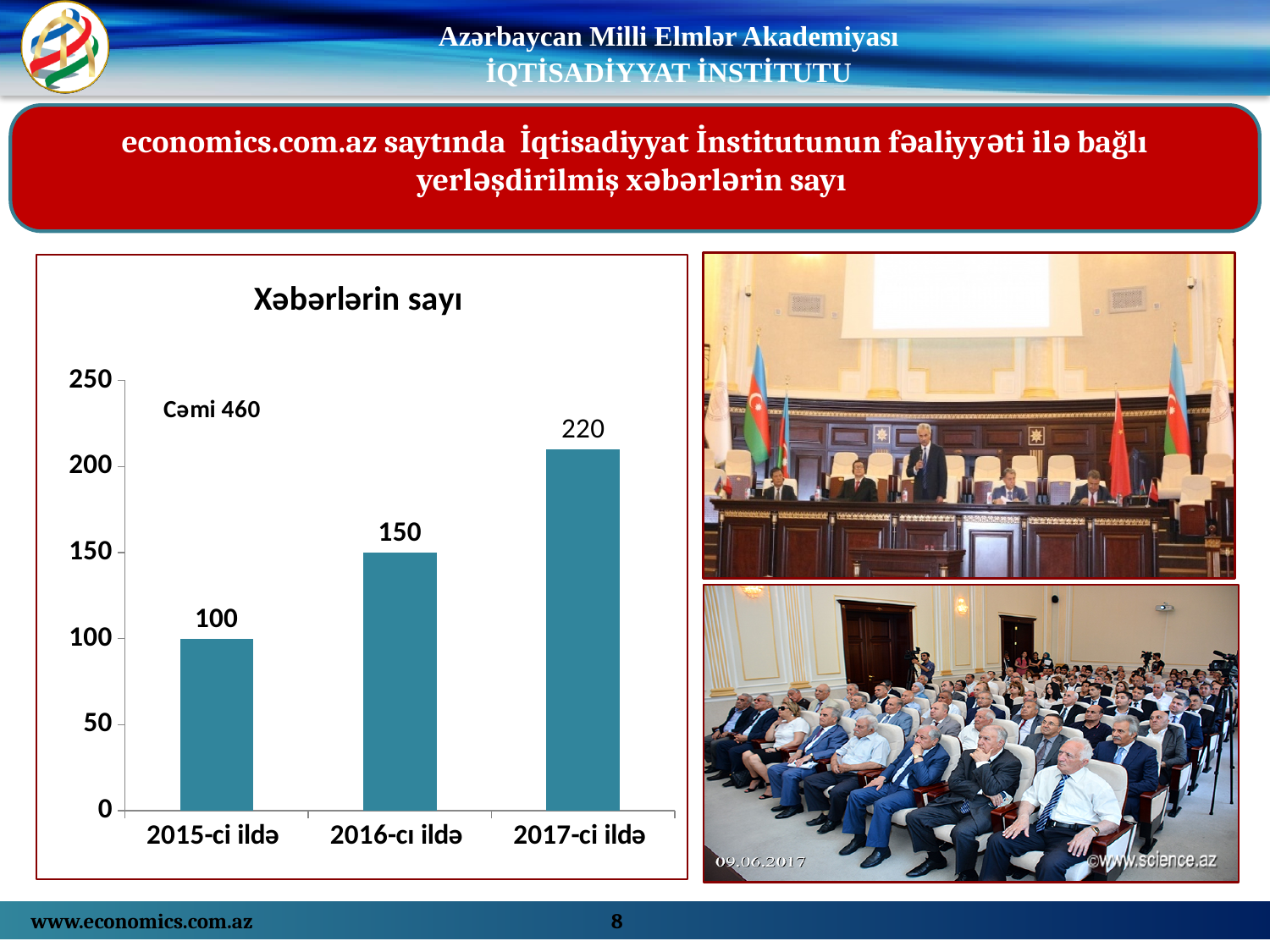
What is the value for 2017-ci ildə? 220 Which is larger, the value for 2016-cı ildə or the value for 2015-ci ildə? 2016-cı ildə What is the difference between the values for 2016-cı ildə and 2015-ci ildə? 50 Is the value for 2017-ci ildə greater or less than 200? greater What is the title of the chart? Xəbərlərin sayı Which year has the lowest number of news items? 2015-ci ildə What is the value for 2016-cı ildə? 150 How many categories are shown on the x axis? 3 Which year has the highest number of news items? 2017-ci ildə What kind of chart is shown on the slide? bar chart What is the value for 2015-ci ildə? 100 What is the difference between the values for 2017-ci ildə and 2016-cı ildə? 70